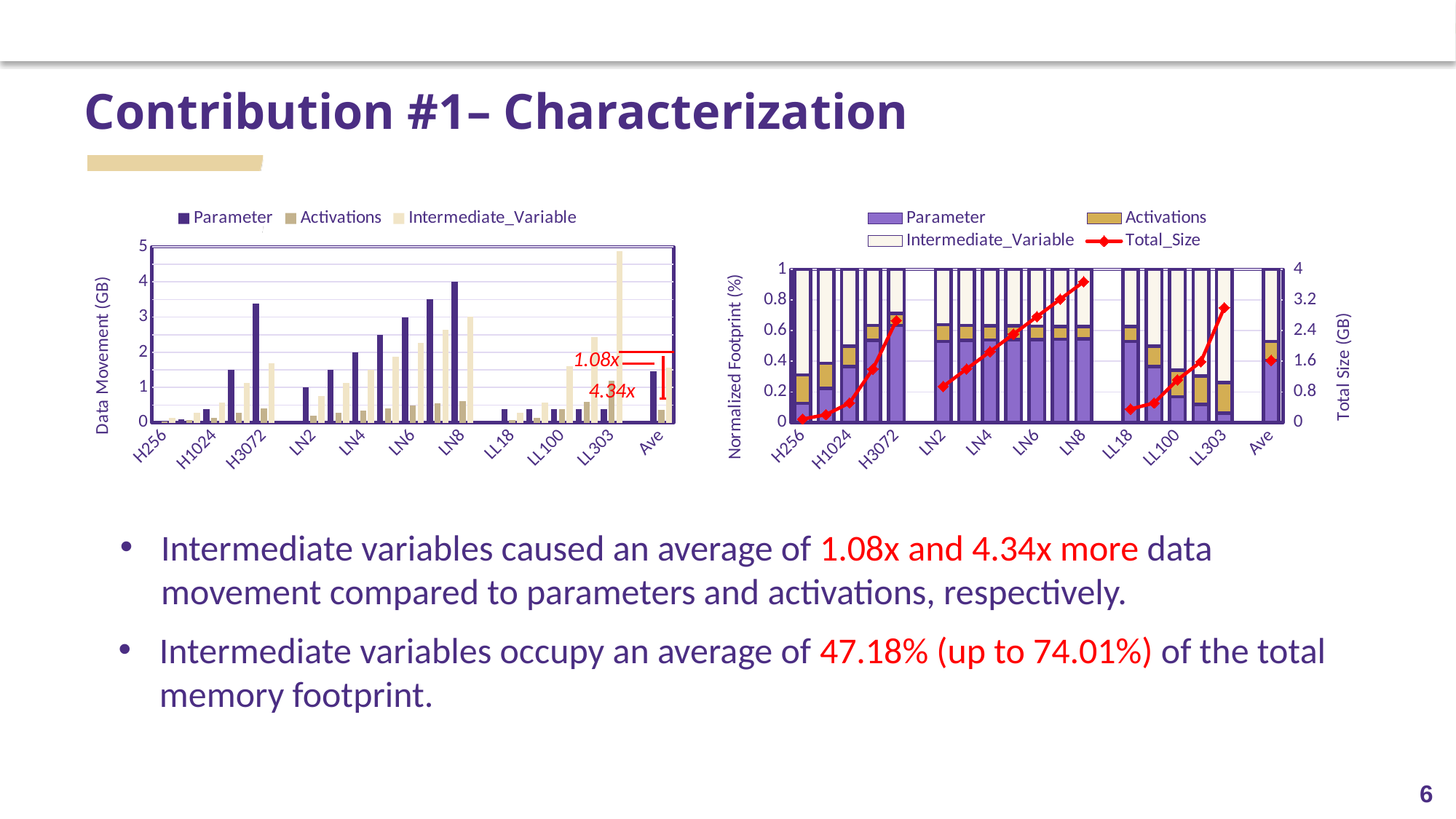
In the left chart (Data Movement), which category has the highest Parameter bar? LN8 In the right chart (Normalized Footprint), is the Total_Size value for H256 greater or less than 0.8? less In the left chart (Data Movement), which is larger for LN8: the Parameter bar or the Intermediate_Variable bar? Parameter In the right chart (Normalized Footprint), does the Total_Size line rise or fall from LN2 to LN8? rise In the left chart (Data Movement), is the Activations value for Ave greater or less than 1? less In the right chart (Normalized Footprint), is the Total_Size value for LN8 greater or less than 3.2? greater What is the title of the secondary (right-hand) y-axis of the right chart? Total Size (GB) What type of chart is the left chart (Data Movement)? bar chart How many series does the legend of the left chart (Data Movement) list? 3 How many entries does the legend of the right chart (Normalized Footprint) list? 4 In the left chart (Data Movement), which category has the highest Intermediate_Variable bar? LL303